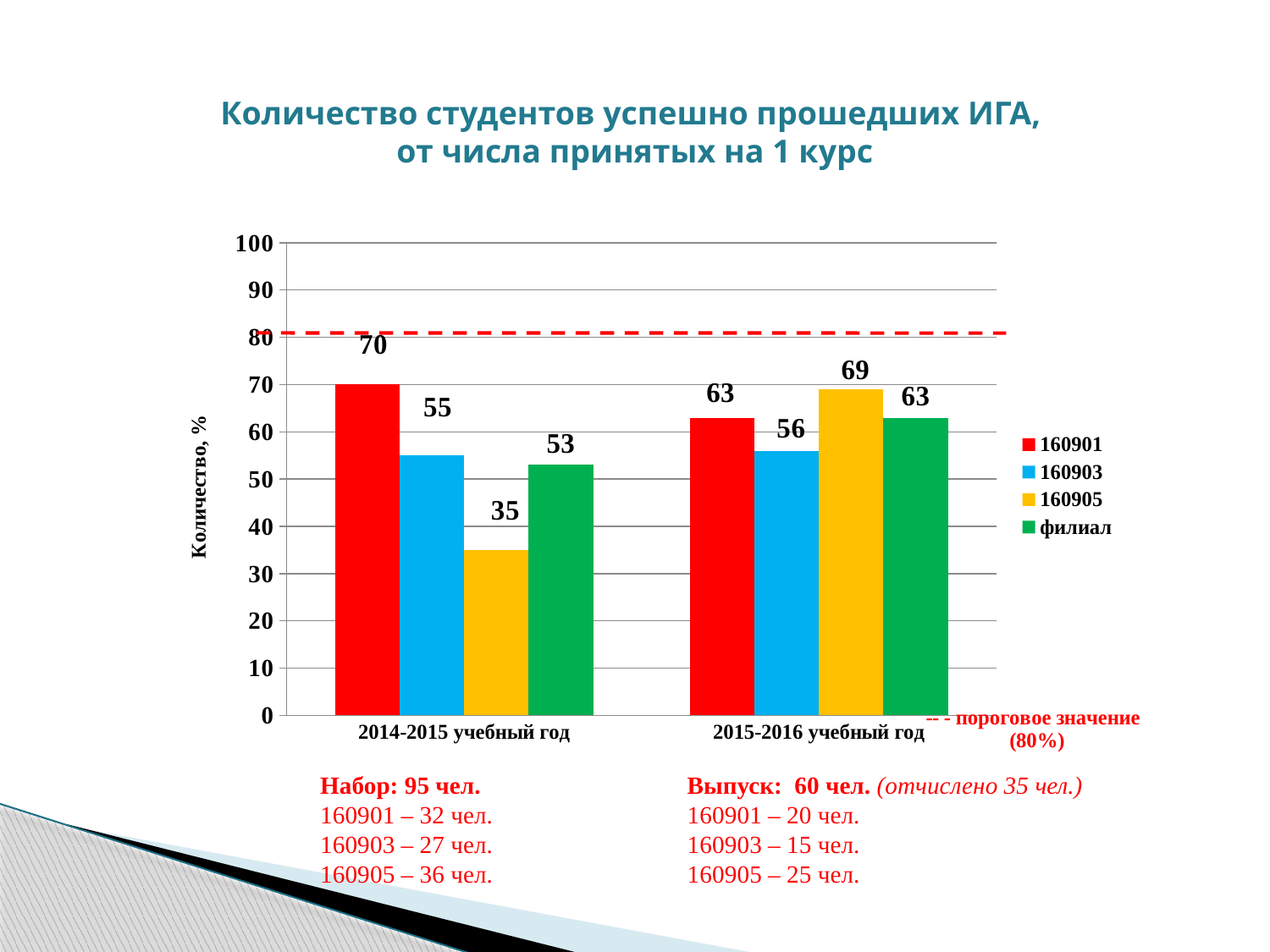
What is the difference between the 160905 values for 2015-2016 and 2014-2015? 34 Which series has the highest value in the 2015-2016 учебный год? 160905 What threshold value does the red dashed line represent? 80% What is the value for филиал in the 2014-2015 учебный год? 53 What is the value for 160905 in the 2015-2016 учебный год? 69 Which series has the lowest value in the 2014-2015 учебный год? 160905 What is the value for 160901 in the 2014-2015 учебный год? 70 Does the value for 160903 rise or fall from 2014-2015 to 2015-2016? rise Which is larger: the value for 160901 in 2014-2015 or in 2015-2016? 2014-2015 How many categories are shown on the x axis? 2 What kind of chart is shown on the slide? bar chart How many series does the legend list? 4